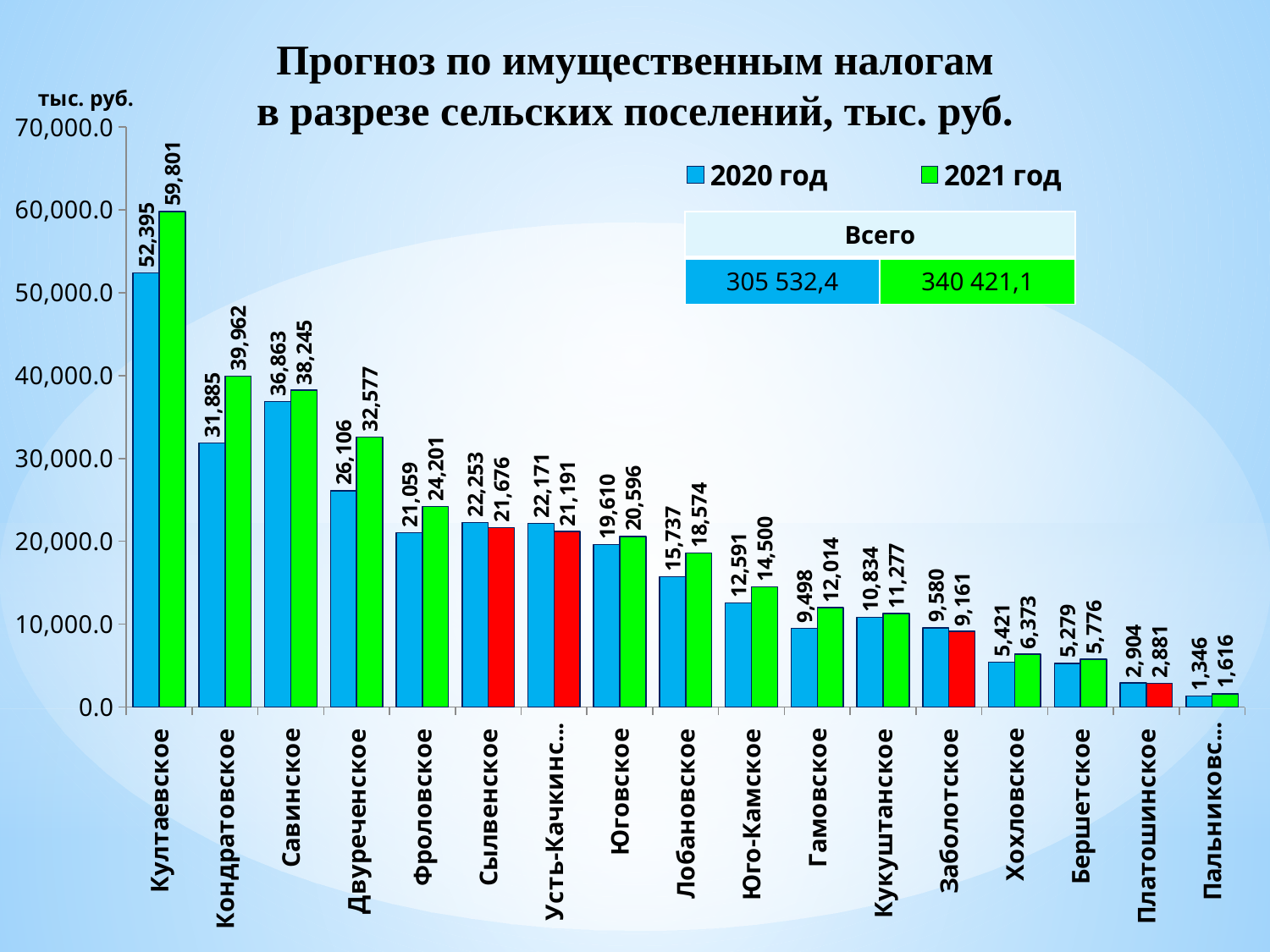
Is the 2021 год value for Двуреченское greater or less than 30,000? greater For Сылвенское, which is larger: the 2020 год value or the 2021 год value? 2020 год What is the difference between the 2021 год and 2020 год values for Двуреченское? 6,471 What kind of chart is shown on the slide? bar chart What is the value for Лобановское in the 2021 год series? 18,574 What is the difference between the 2021 год and 2020 год values for Култаевское? 7,406 Do the 2020 год values generally rise or fall from left to right along the x axis? fall Which settlement has the highest value in the 2020 год series? Култаевское What is the value for Култаевское in the 2021 год series? 59,801 How many settlements (categories) are shown on the x axis? 17 What is the value for Гамовское in the 2020 год series? 9,498 How many series does the legend list? 2